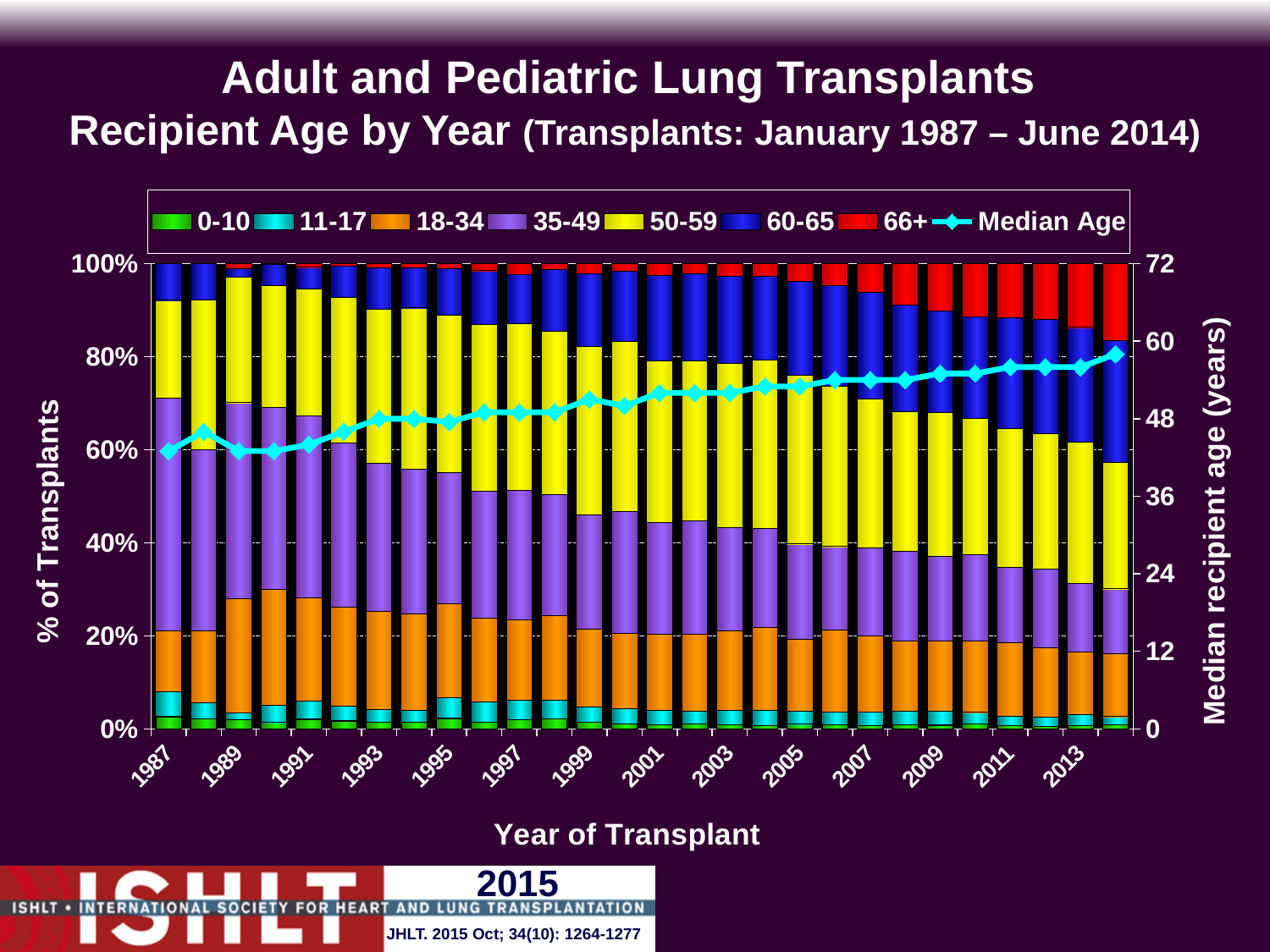
What colour represents the 66+ age group in the legend? Red Does the share of recipients aged 35-49 rise or fall from 1987 to 2014? Falls How many years (bars) are plotted along the x axis? 28 Is the share of recipients aged 35-49 larger in 1987 or in 2014? 1987 What kind of chart is shown on the slide? Stacked bar chart with a line Does the median recipient age rise or fall from 1987 to 2014? Rises Is the median recipient age in 2014 greater or less than 48 years? greater Is the share of recipients aged 66+ in 2014 greater or less than 20%? less Is the median recipient age in 1987 greater or less than 48 years? less What is the title of the x axis? Year of Transplant Which year has the highest median recipient age? 2014 How many entries does the legend list? 8